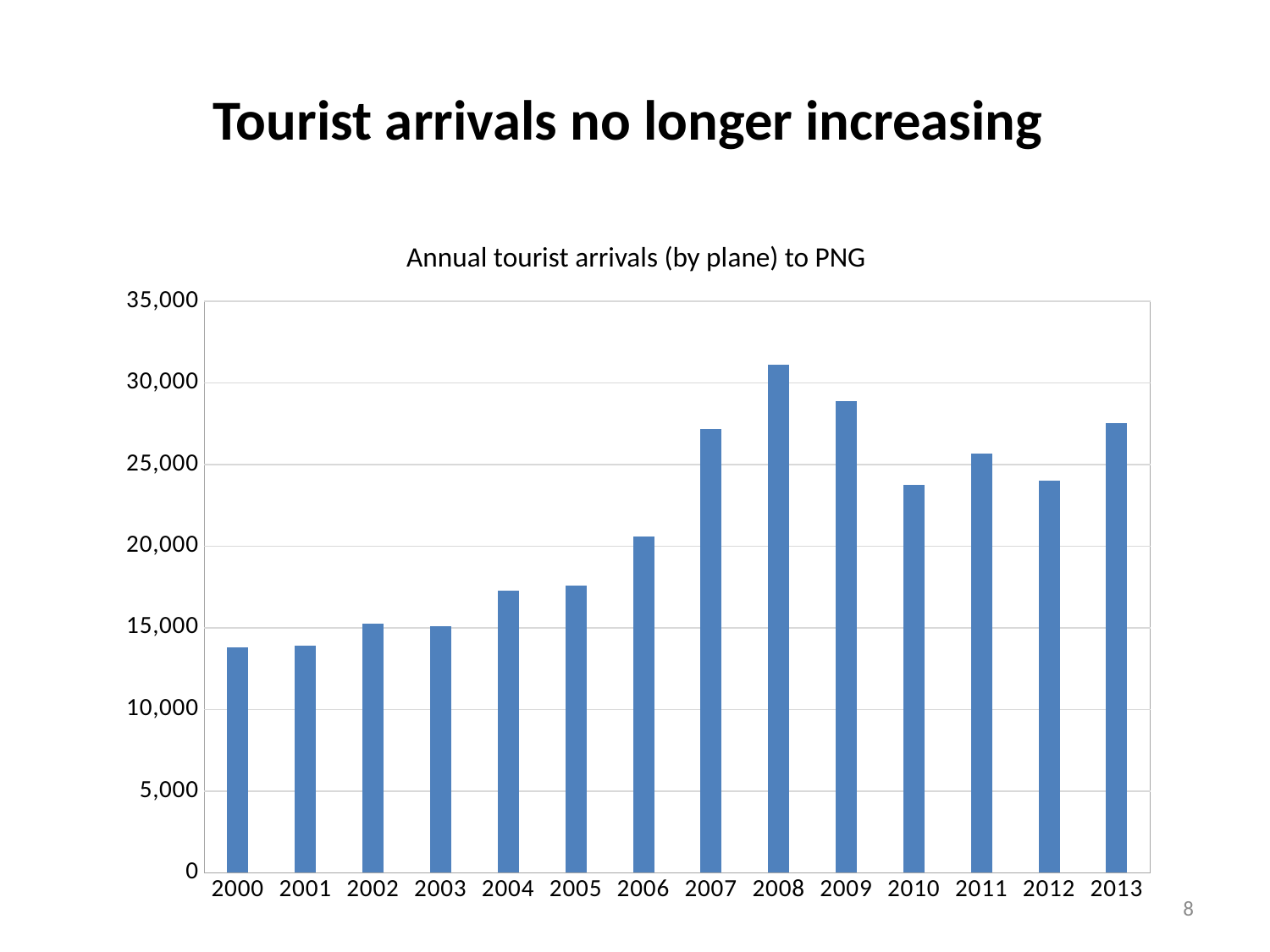
How many years are plotted on the x axis of the chart? 14 Which year has more tourist arrivals, 2010 or 2011? 2011 Do tourist arrivals generally rise or fall from 2000 to 2008? rise Is the value for 2000 greater or less than 15,000? less Which year has the highest number of tourist arrivals? 2008 What is the title of the chart? Annual tourist arrivals (by plane) to PNG Is the value for 2013 greater or less than 25,000? greater Is the value for 2008 greater or less than 30,000? greater What kind of chart is shown on the slide? bar chart Which year has more tourist arrivals, 2008 or 2009? 2008